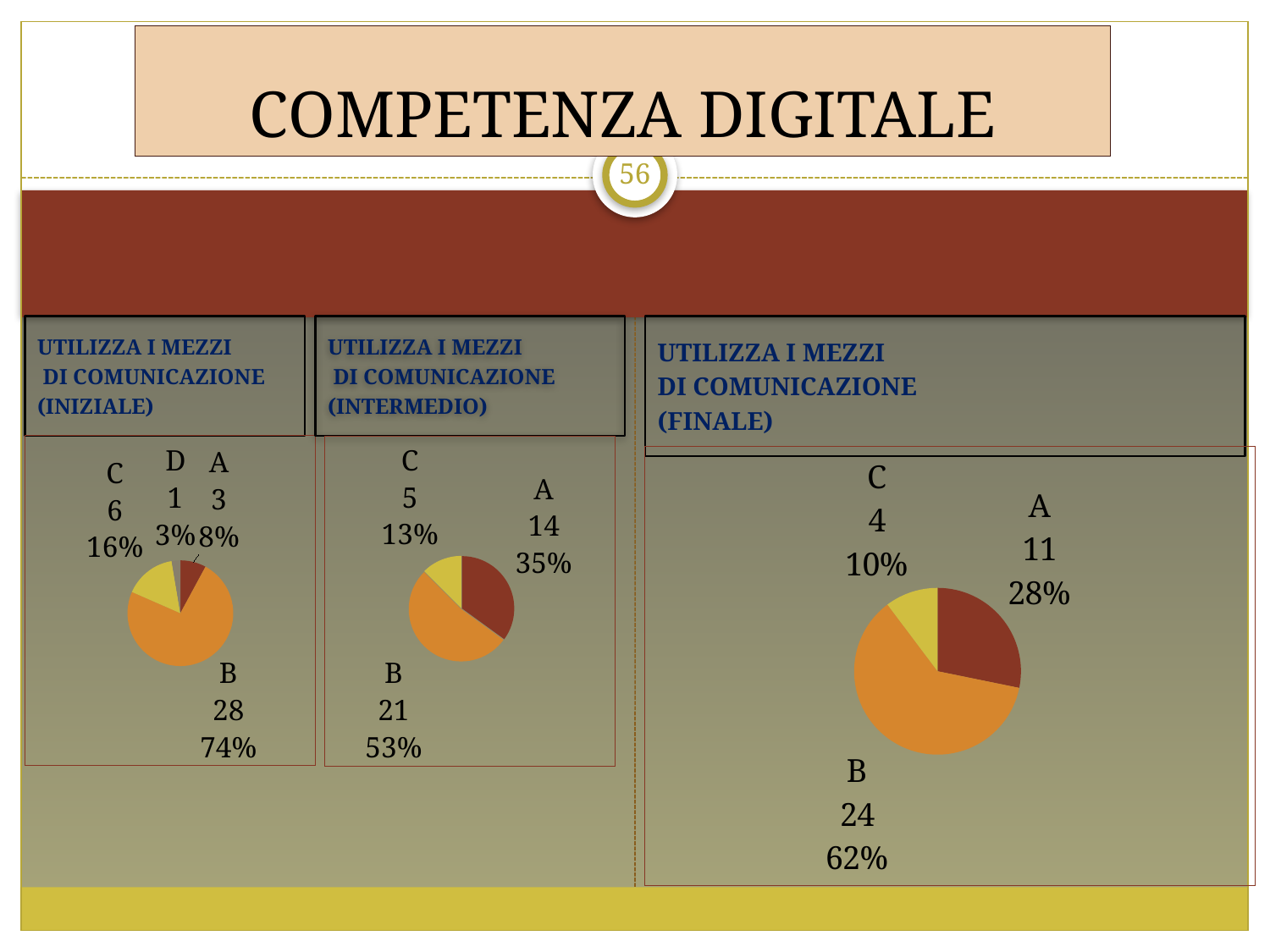
In the UTILIZZA I MEZZI DI COMUNICAZIONE (INIZIALE) chart, what percentage share does category C have? 16% In the UTILIZZA I MEZZI DI COMUNICAZIONE (INIZIALE) chart, which category has the smallest value? D In the UTILIZZA I MEZZI DI COMUNICAZIONE (INTERMEDIO) chart, what is the difference between the values for B and A? 7 In the UTILIZZA I MEZZI DI COMUNICAZIONE (INIZIALE) chart, what is the value for category B? 28 What kind of chart is the UTILIZZA I MEZZI DI COMUNICAZIONE (FINALE) chart? Pie chart In the UTILIZZA I MEZZI DI COMUNICAZIONE (INTERMEDIO) chart, what is the value for category A? 14 In the UTILIZZA I MEZZI DI COMUNICAZIONE (INTERMEDIO) chart, what percentage share does category B have? 53% In the UTILIZZA I MEZZI DI COMUNICAZIONE (FINALE) chart, which is larger, the value for A or the value for C? A In the UTILIZZA I MEZZI DI COMUNICAZIONE (FINALE) chart, what is the value for category C? 4 In the UTILIZZA I MEZZI DI COMUNICAZIONE (FINALE) chart, which category has the largest value? B How many categories are shown in the UTILIZZA I MEZZI DI COMUNICAZIONE (INIZIALE) chart? 4 How many categories are shown in the UTILIZZA I MEZZI DI COMUNICAZIONE (FINALE) chart? 3